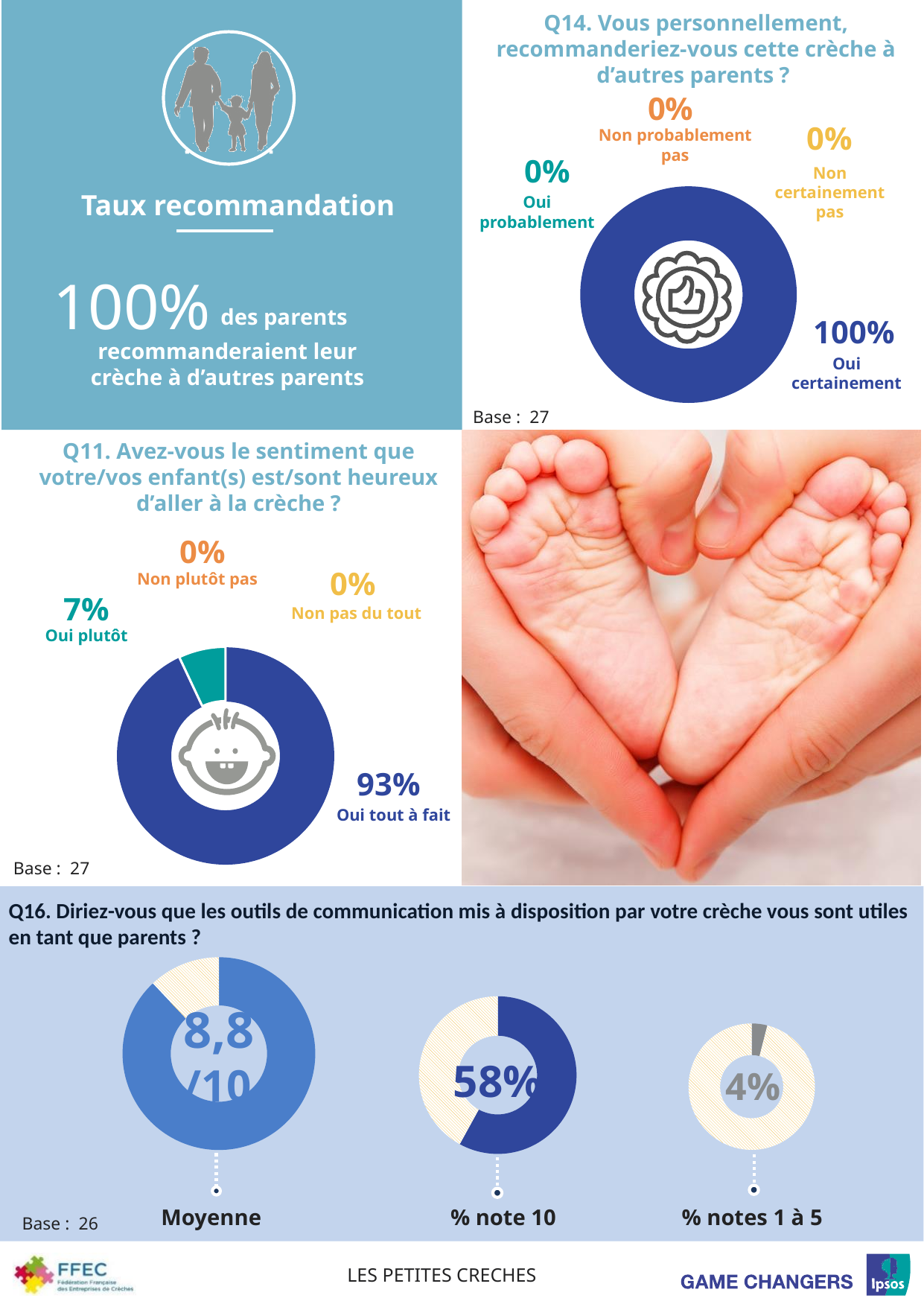
In the Q11 chart, which response category has the highest share? Oui tout à fait In the Q14 chart (recommending the crèche to other parents), what percentage of parents answered "Oui certainement"? 100% In the Q11 chart, which is larger: "Oui plutôt" or "Non plutôt pas"? Oui plutôt In the Q16 section, what percentage of parents gave scores of 1 to 5 ("% notes 1 à 5")? 4% What type of chart is used for the Q14 and Q11 results? Donut (pie) chart In the Q11 chart, what is the difference in percentage points between "Oui tout à fait" and "Oui plutôt"? 86 In the Q16 section (communication tools), what is the average score shown in the "Moyenne" chart? 8,8/10 In the Q16 section, what percentage of parents gave a score of 10 ("% note 10")? 58% In the Q11 chart, how many response categories are labelled? 4 In the Q11 chart (children happy to go to the crèche), what percentage answered "Oui tout à fait"? 93% In the Q14 chart, what percentage answered "Oui probablement"? 0% In the Q11 chart, what percentage answered "Oui plutôt"? 7%